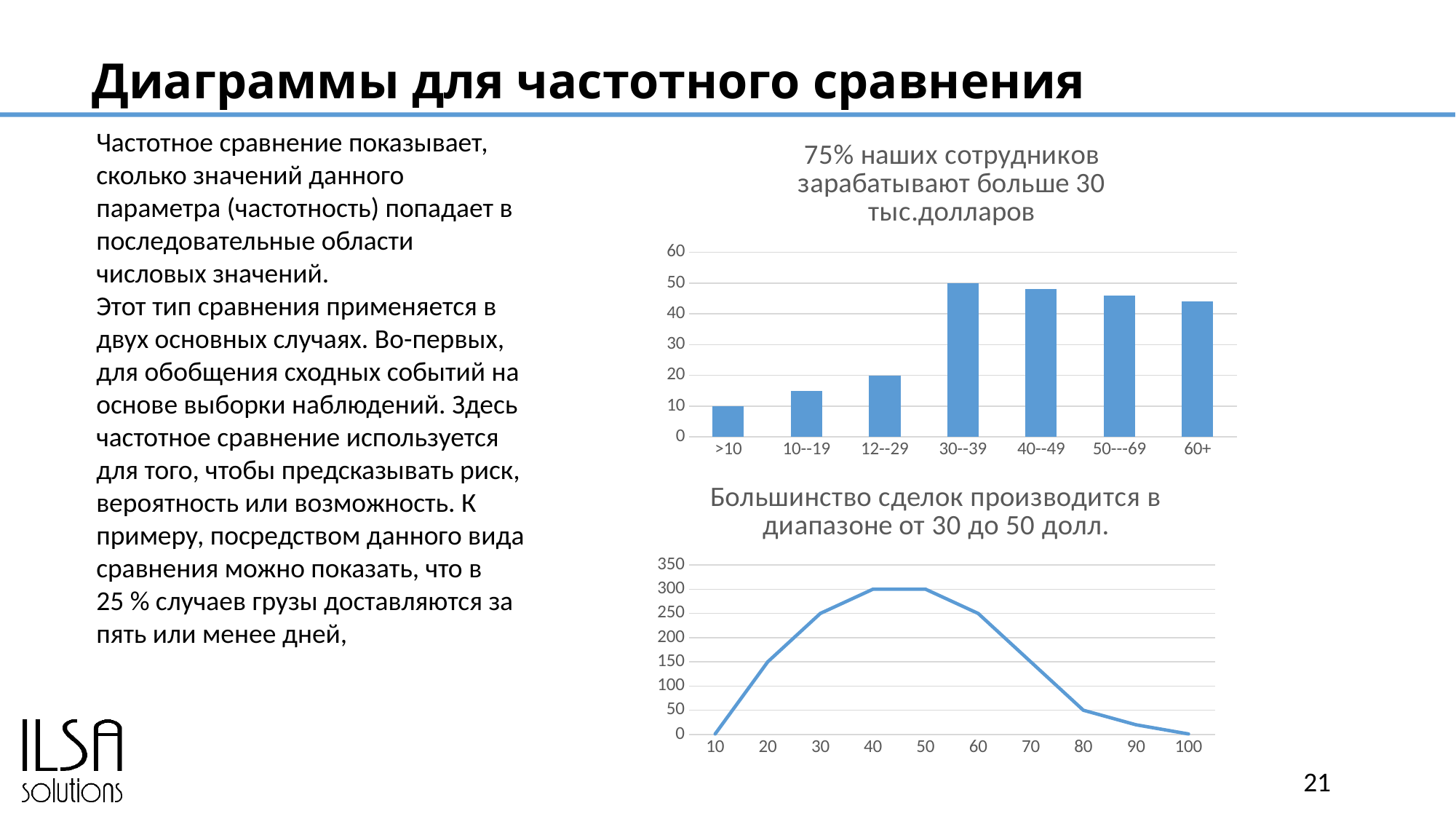
In the top bar chart, which is larger: the value for "12--29" or the value for "60+"? 60+ In the bottom line chart, what is the value at x = 80? 50 In the bottom line chart, what is the value at x = 40? 300 What kind of chart is the top chart titled "75% наших сотрудников зарабатывают больше 30 тыс.долларов"? bar chart What kind of chart is the bottom chart titled "Большинство сделок производится в диапазоне от 30 до 50 долл."? line chart In the top bar chart, which category has the lowest value? >10 In the top bar chart, which category has the highest value? 30--39 In the top bar chart, how many categories are shown on the x axis? 7 In the top bar chart, what is the value for the category ">10"? 10 In the top bar chart, what is the value for the category "30--39"? 50 In the top bar chart, is the value for "10--19" greater or less than 20? less In the bottom line chart, how many points are plotted along the x axis? 10